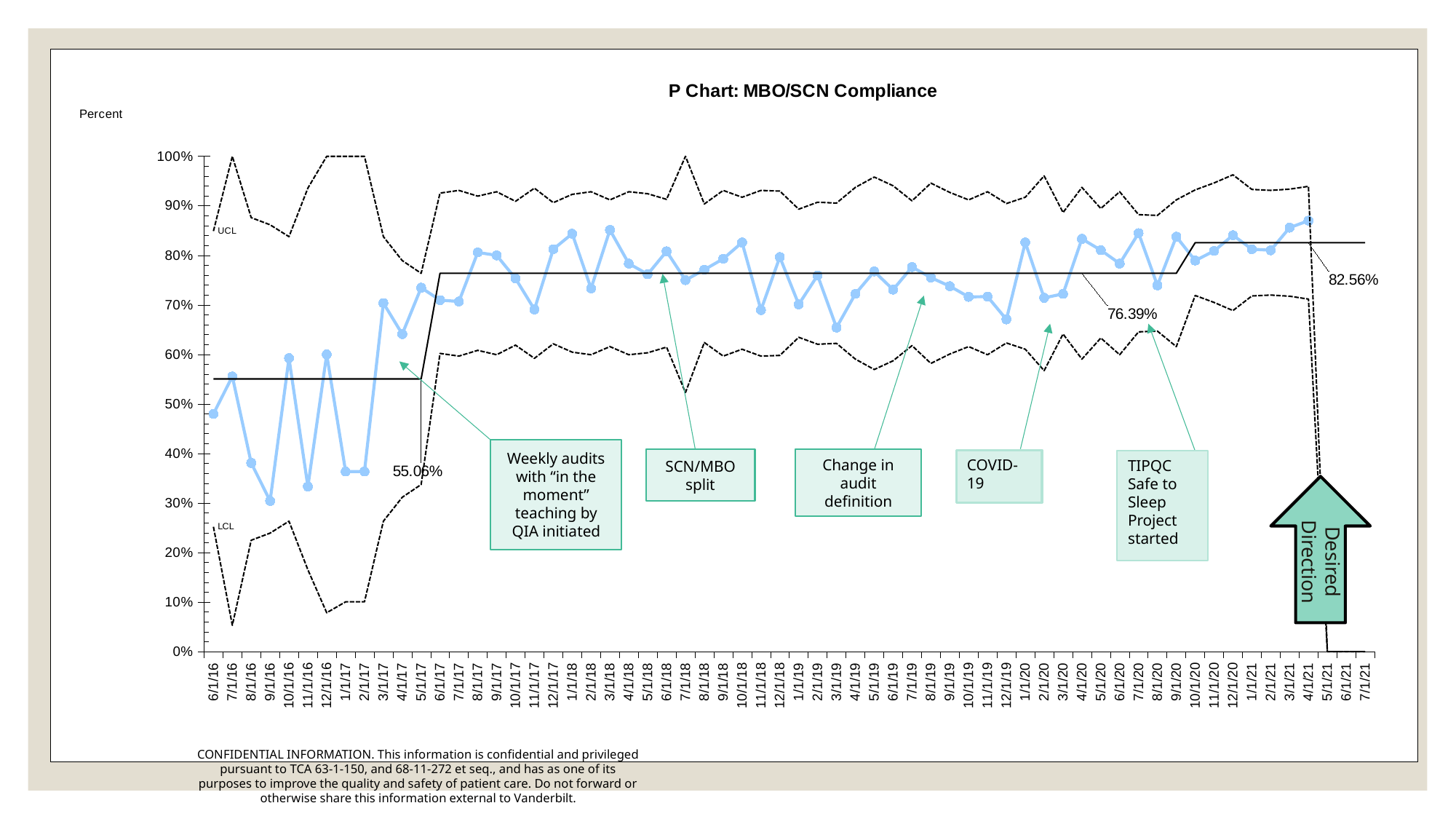
Is the plotted compliance value for 4/1/21 greater or less than 80%? greater What is the title of the chart? P Chart: MBO/SCN Compliance By how many percentage points does the middle center line (76.39%) exceed the first center line (55.06%)? 21.33 Overall, do the plotted compliance values rise or fall from 6/1/16 to 4/1/21? rise What is the value of the center line segment labeled near 7/1/20? 76.39% What is the value of the final center line segment, labeled near 5/1/21? 82.56% What label is shown on the vertical axis of the chart? Percent By how many percentage points does the final center line (82.56%) exceed the middle center line (76.39%)? 6.17 What is the value of the first center line segment, labeled near 5/1/17? 55.06% Which of the three labeled center line values is the highest? 82.56% What kind of chart is shown on the slide? line chart Is the plotted compliance value for 9/1/16 greater or less than 40%? less